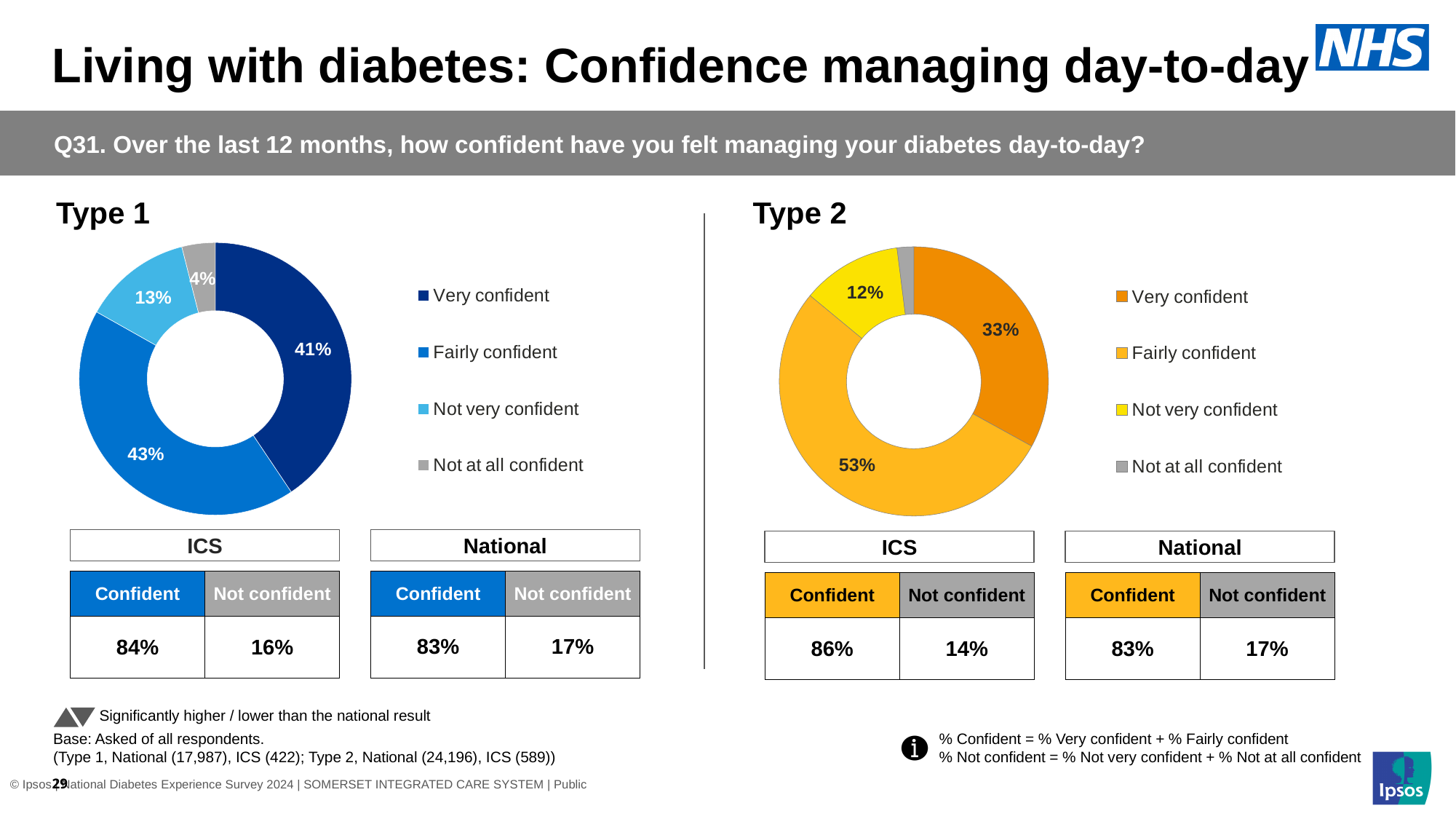
In the Type 1 chart, what percentage of respondents were very confident? 41% In the Type 1 chart, what percentage of respondents were fairly confident? 43% In the Type 2 chart, what percentage of respondents were fairly confident? 53% In the Type 2 chart, what percentage of respondents were very confident? 33% In the Type 1 chart, which category has the smallest share? Not at all confident In the Type 2 chart, what percentage of respondents were not very confident? 12% In the Type 1 chart, what percentage of respondents were not at all confident? 4% How many categories does the legend of the Type 2 chart list? 4 What kind of chart is used for the Type 1 data? Donut (pie) chart In the Type 2 chart, which category has the largest share? Fairly confident Is the very confident share larger in the Type 1 chart or the Type 2 chart? Type 1 In the Type 2 chart, what is the difference between the fairly confident and very confident shares? 20 percentage points